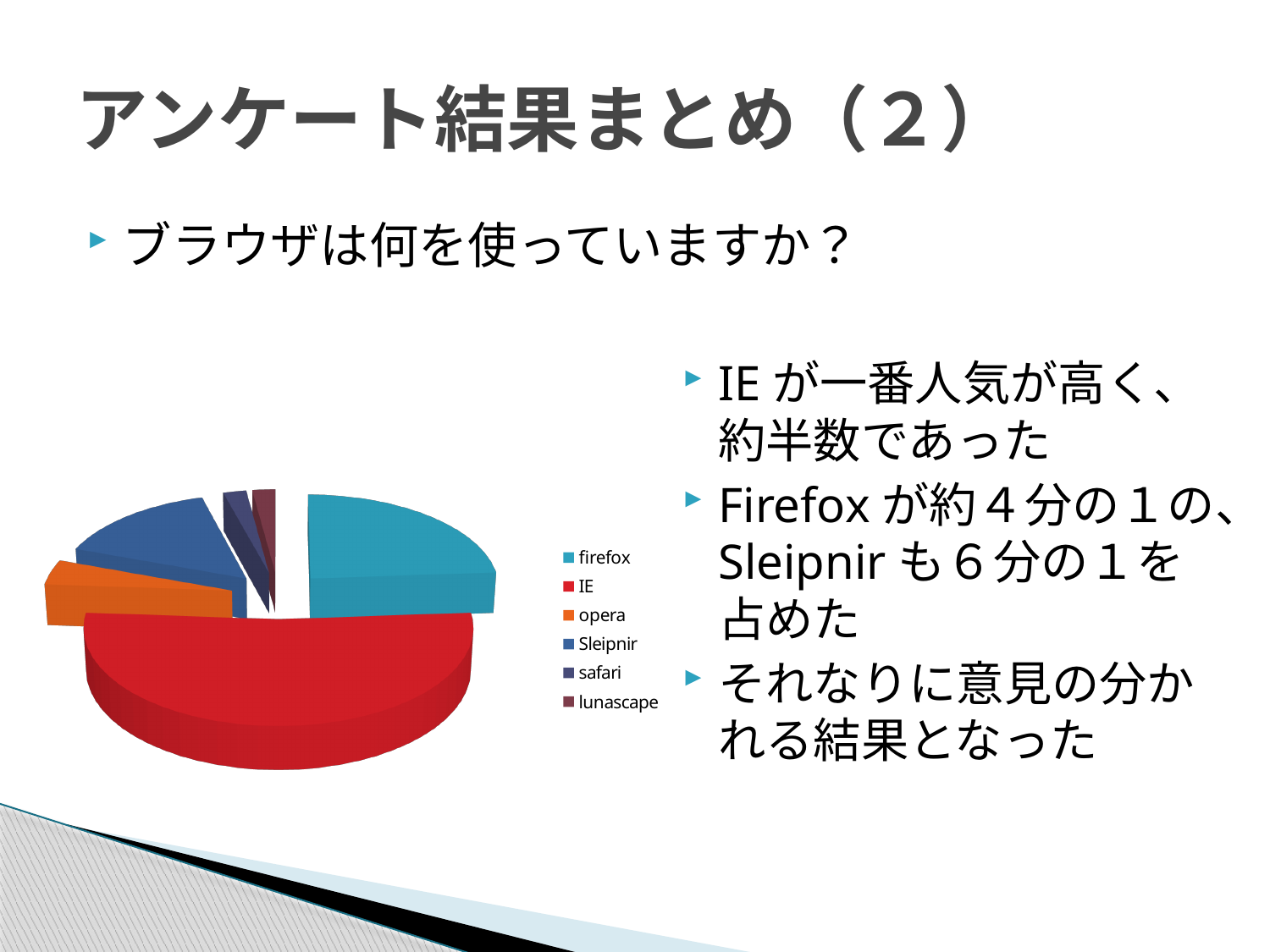
Which browser has the largest slice in the pie chart? IE Which slice is larger, firefox or Sleipnir? firefox How many categories (slices) does the pie chart have? 6 What kind of chart is shown on the slide? pie chart Which slice is larger, opera or safari? opera What colour is the IE slice in the pie chart? red Which slice is larger, Sleipnir or opera? Sleipnir Which legend entry is listed first in the pie chart's legend? firefox